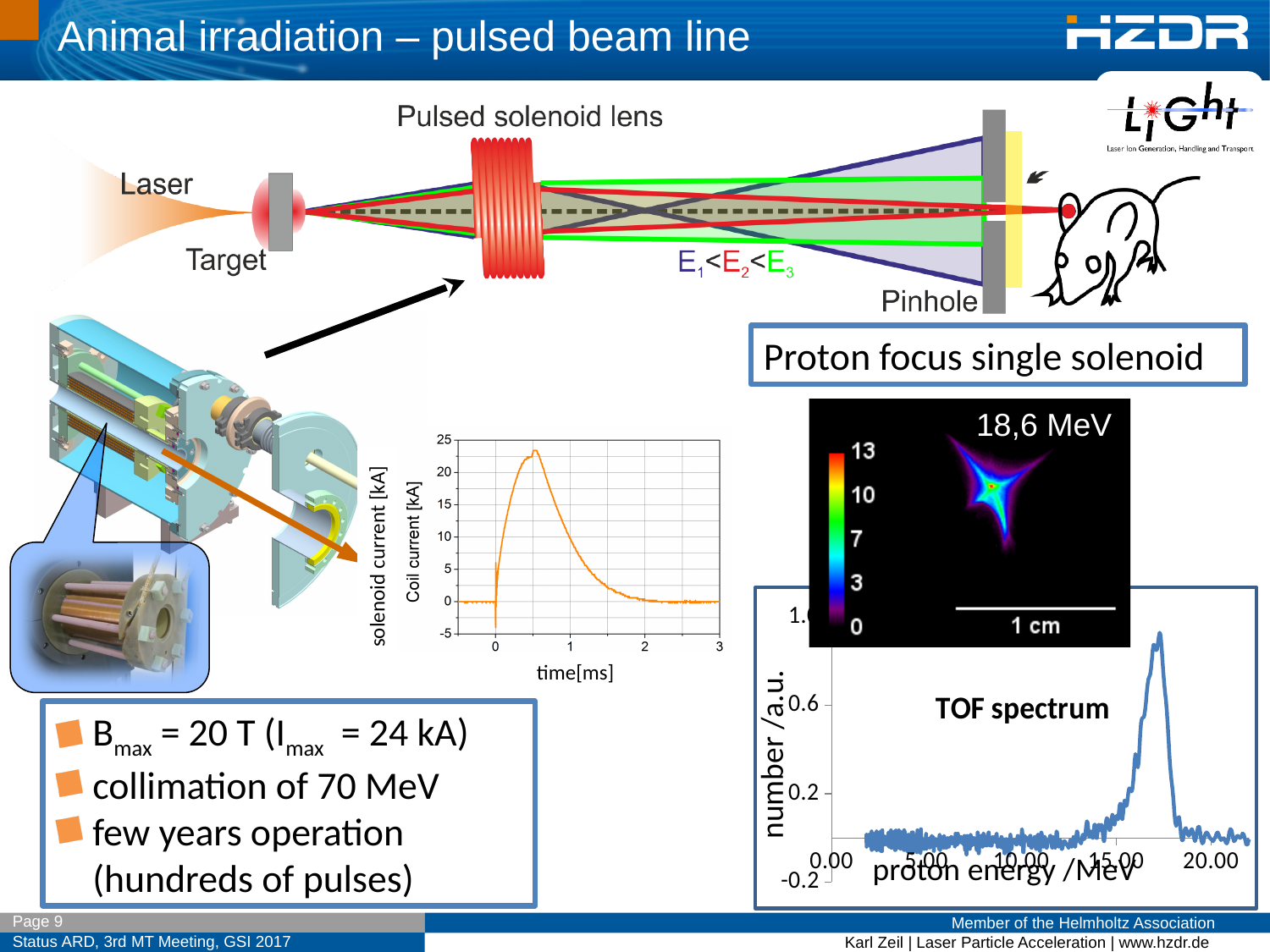
In the solenoid current chart, is the peak current greater or less than 20 kA? greater What kind of chart is the TOF spectrum chart at the bottom right? line chart In the solenoid current chart, what is the label of the y axis? solenoid current [kA] In the TOF spectrum chart, is the peak located between 15.00 and 20.00 MeV or between 5.00 and 10.00 MeV? between 15.00 and 20.00 MeV In the solenoid current chart, does the current rise or fall between 1 ms and 2 ms? fall What kind of chart is the solenoid current chart in the middle of the slide? line chart In the TOF spectrum chart, is the peak value greater or less than 0.6? greater In the solenoid current chart, is the current at 2 ms greater or less than 5 kA? less In the solenoid current chart, is the peak current reached before or after 1 ms? before In the solenoid current chart, what is the label of the x axis? time[ms] In the TOF spectrum chart, what is the label of the x axis? proton energy /MeV